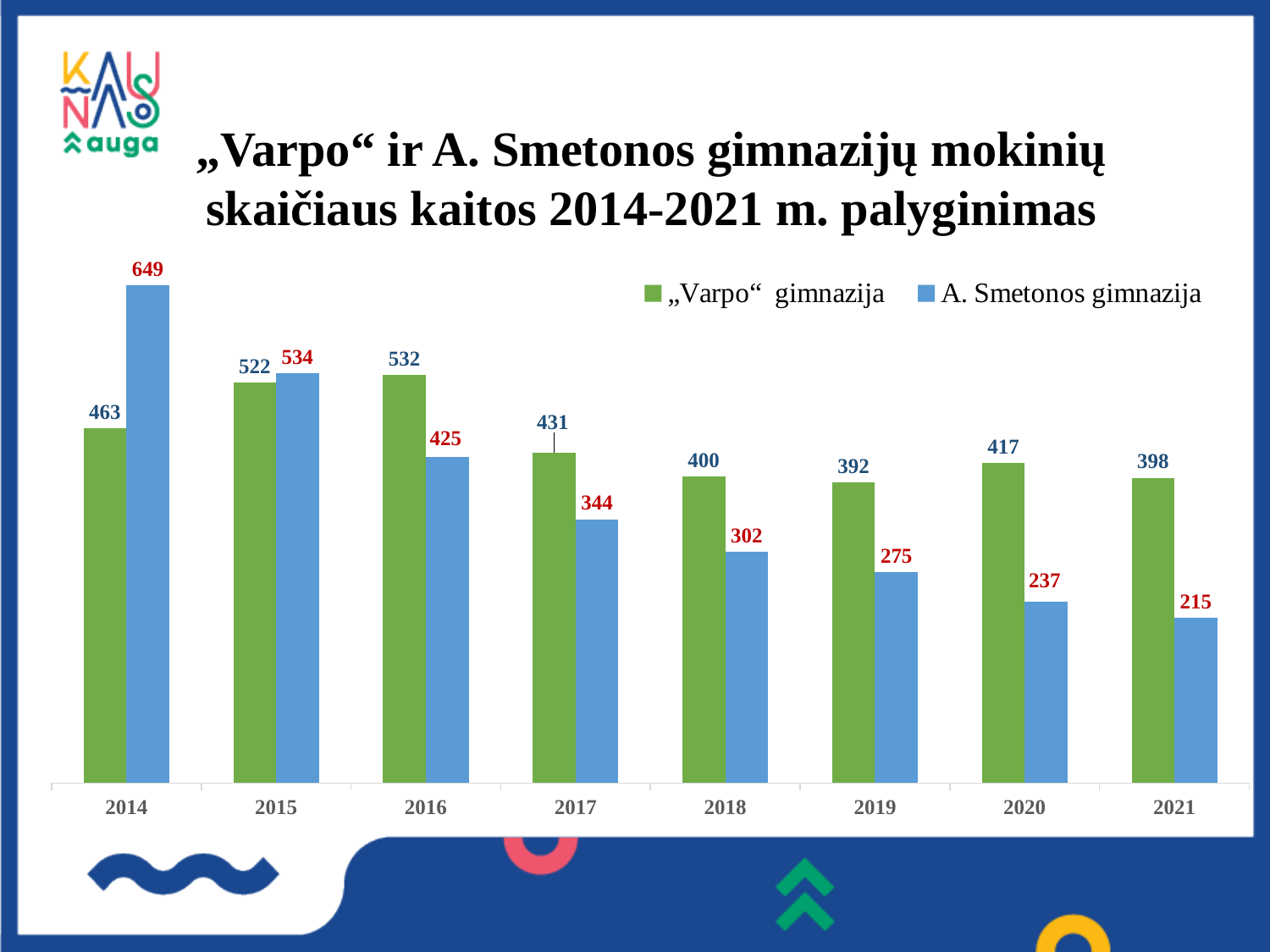
What is the difference between the „Varpo“ gimnazija and A. Smetonos gimnazija values in 2020? 180 How many series does the legend list? 2 What kind of chart is shown on the slide? Bar chart Which is larger in 2015: „Varpo“ gimnazija or A. Smetonos gimnazija? A. Smetonos gimnazija What is the value for A. Smetonos gimnazija in 2021? 215 In which year is the value for A. Smetonos gimnazija highest? 2014 What is the value for „Varpo“ gimnazija in 2014? 463 What is the value for A. Smetonos gimnazija in 2017? 344 How many years are shown on the x axis? 8 Which colour represents A. Smetonos gimnazija in the chart? Blue Does the value for A. Smetonos gimnazija rise or fall from 2014 to 2021? Fall In which year is the value for „Varpo“ gimnazija lowest? 2019